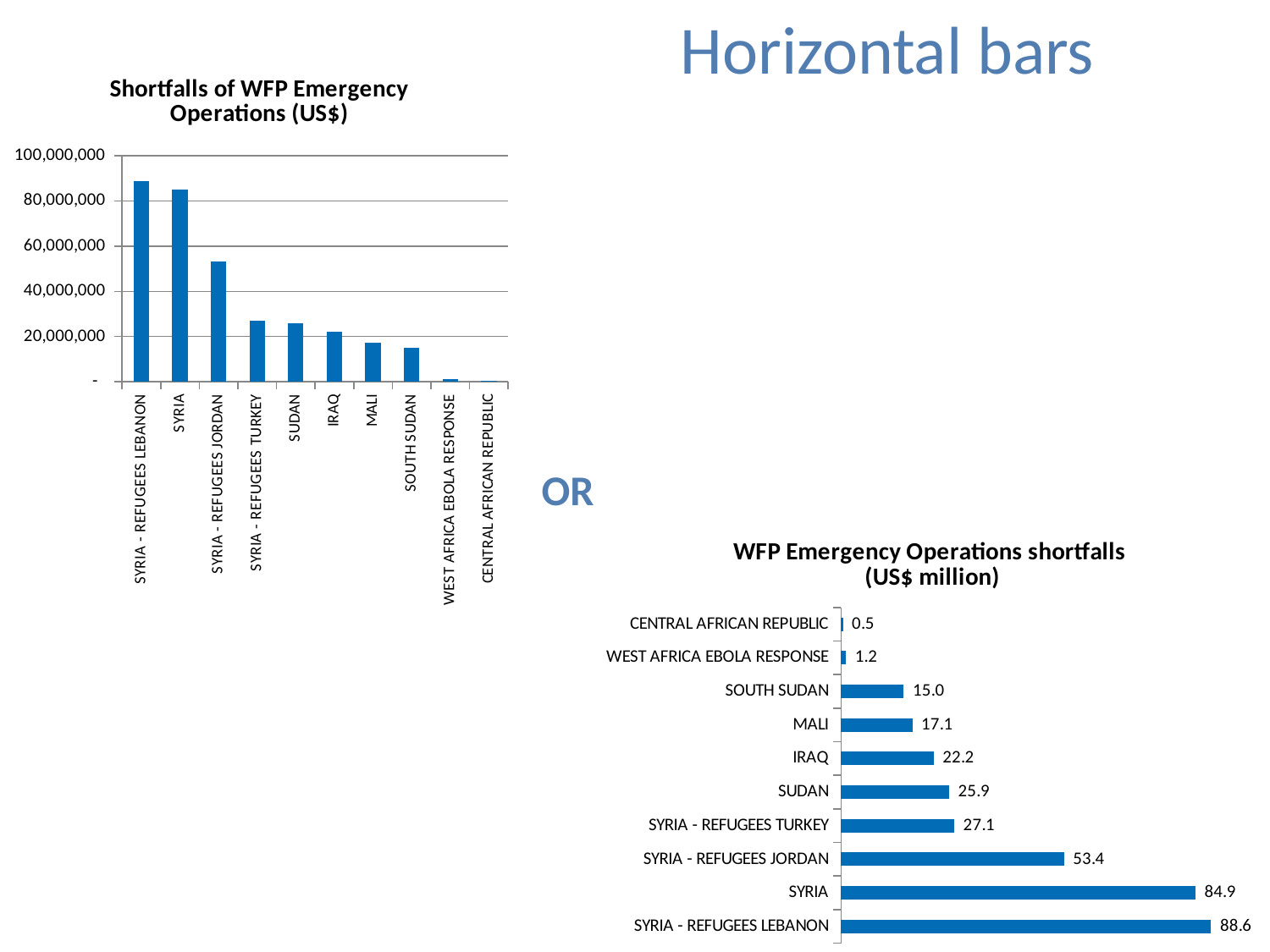
In the 'Shortfalls of WFP Emergency Operations (US$)' chart on the left, is the value for MALI greater or less than 20,000,000? less In the 'Shortfalls of WFP Emergency Operations (US$)' chart on the left, is the value for SYRIA - REFUGEES JORDAN greater or less than 40,000,000? greater In the 'WFP Emergency Operations shortfalls (US$ million)' chart, which category has the highest value? SYRIA - REFUGEES LEBANON How many categories are shown in the 'WFP Emergency Operations shortfalls (US$ million)' chart? 10 What kind of chart is the 'Shortfalls of WFP Emergency Operations (US$)' chart on the left? Bar chart In the 'WFP Emergency Operations shortfalls (US$ million)' chart, which is larger, the value for MALI or the value for SOUTH SUDAN? MALI In the 'WFP Emergency Operations shortfalls (US$ million)' chart, what is the value for SYRIA - REFUGEES JORDAN? 53.4 In the 'WFP Emergency Operations shortfalls (US$ million)' chart, what is the difference between the values for SYRIA and IRAQ? 62.7 In the 'WFP Emergency Operations shortfalls (US$ million)' chart, what is the value for SUDAN? 25.9 In the 'Shortfalls of WFP Emergency Operations (US$)' chart on the left, do the values rise or fall from left to right along the x axis? fall In the 'WFP Emergency Operations shortfalls (US$ million)' chart, what is the value for WEST AFRICA EBOLA RESPONSE? 1.2 In the 'WFP Emergency Operations shortfalls (US$ million)' chart, which category has the lowest value? CENTRAL AFRICAN REPUBLIC